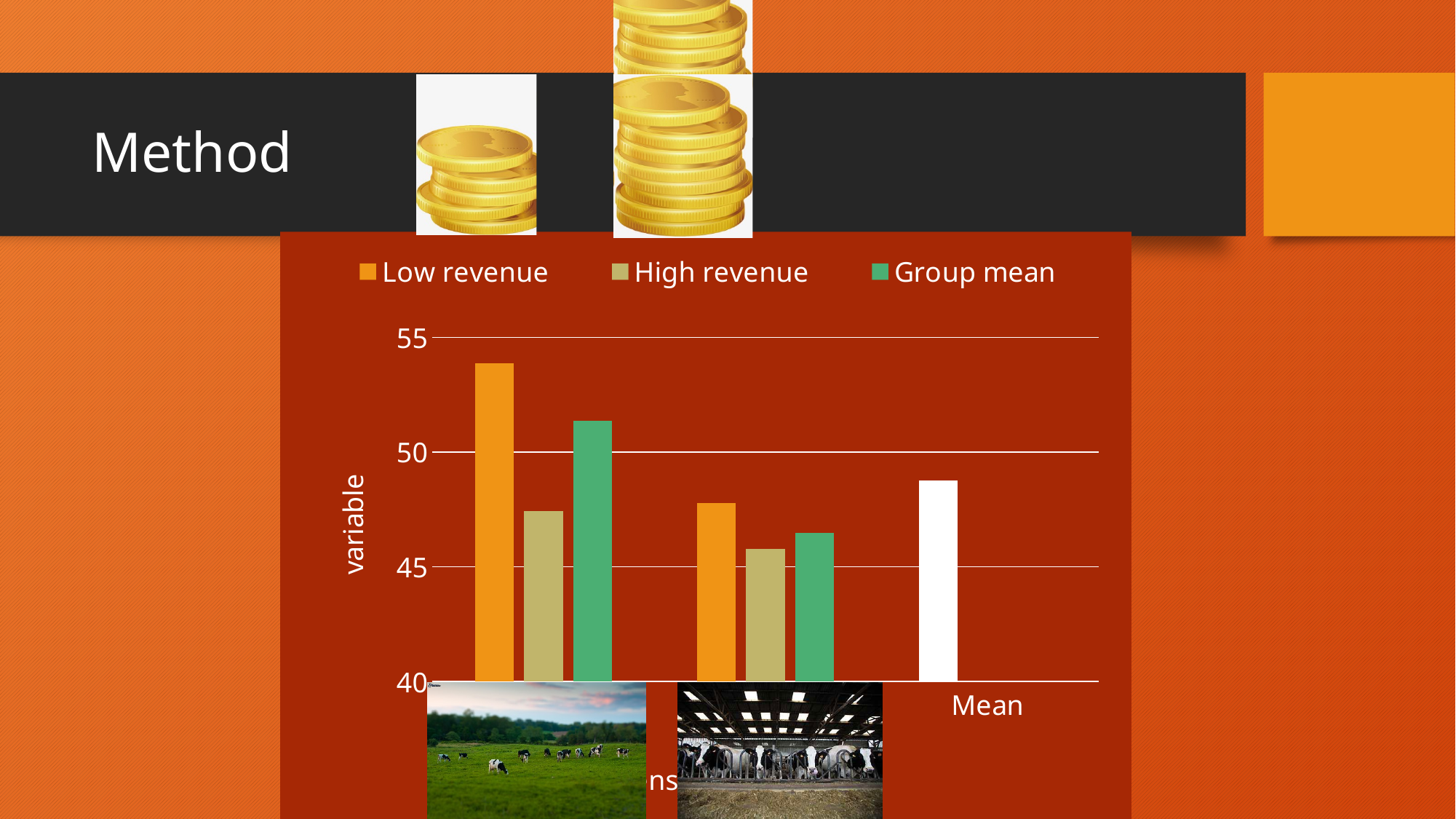
What is the title of the vertical axis of the chart? variable How many series does the chart legend list? 3 What kind of chart is shown on the slide? bar chart Is the value of the white bar for Mean greater or less than 45? greater Which series has the tallest bar in the chart? Low revenue Is the tallest Low revenue bar greater or less than 50? greater Which series has the shortest bar in the chart? High revenue What is the highest value shown on the vertical axis of the chart? 55 Which is larger: the tallest Low revenue bar or the white Mean bar? the tallest Low revenue bar Is the shortest Group mean bar greater or less than 50? less